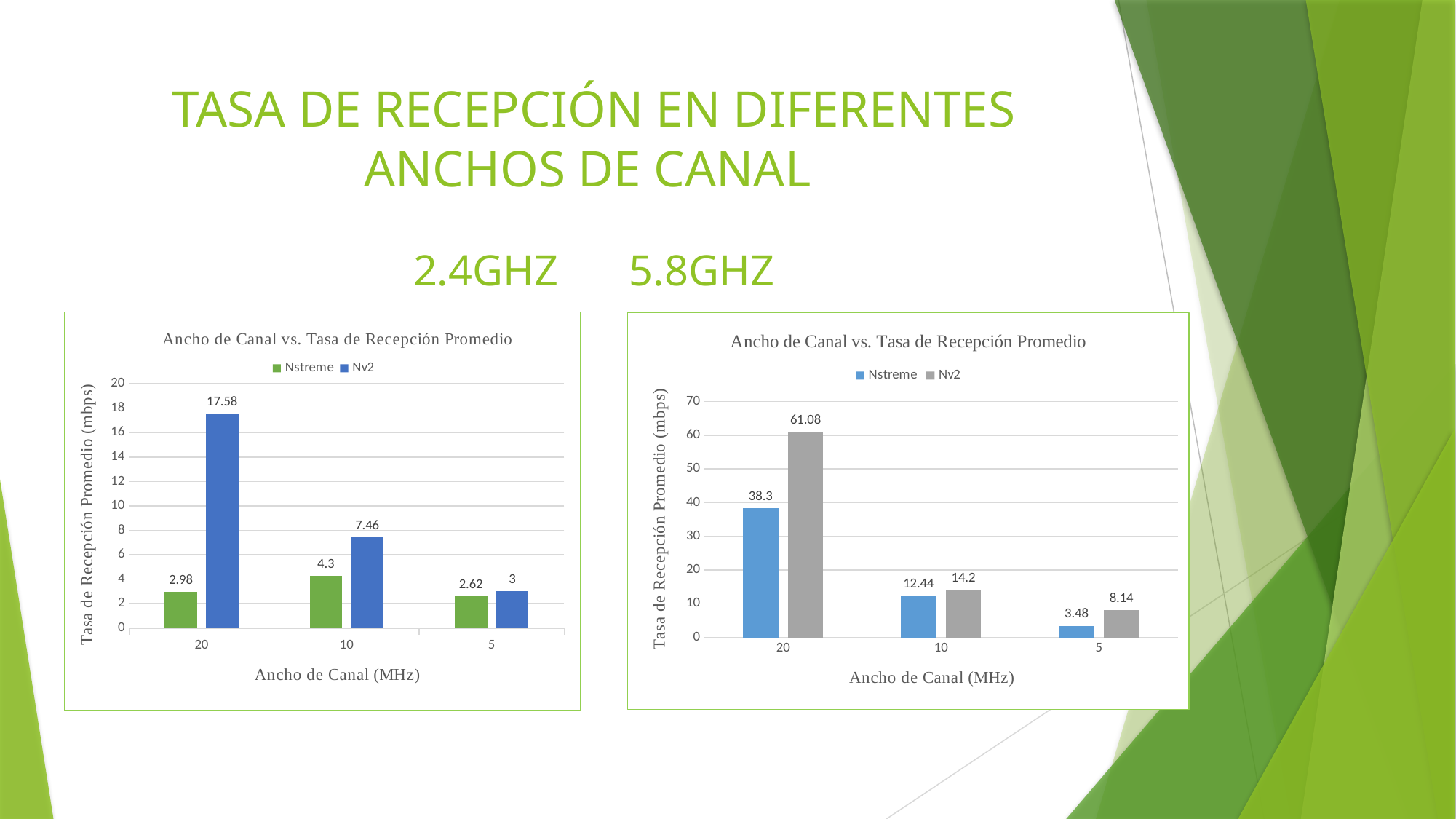
In the 2.4GHz chart (left), which channel width has the lowest Nstreme value? 5 What kind of chart is the 5.8GHz chart (right)? Bar chart In the 2.4GHz chart (left), what is the value for Nv2 at 20 MHz? 17.58 In the 5.8GHz chart (right), what is the value for Nstreme at 10 MHz? 12.44 How many series does the legend of the 2.4GHz chart (left) list? 2 In the 2.4GHz chart (left), what is the difference between Nv2 and Nstreme at 10 MHz? 3.16 How many channel width categories are shown on the x axis of the 5.8GHz chart (right)? 3 In the 5.8GHz chart (right), which channel width has the highest Nv2 value? 20 In the 5.8GHz chart (right), which is larger at 5 MHz, Nstreme or Nv2? Nv2 What is the x-axis label of the 2.4GHz chart (left)? Ancho de Canal (MHz) In the 5.8GHz chart (right), what is the difference between Nv2 and Nstreme at 20 MHz? 22.78 In the 2.4GHz chart (left), is the value for Nv2 at 20 MHz greater or less than 16? greater